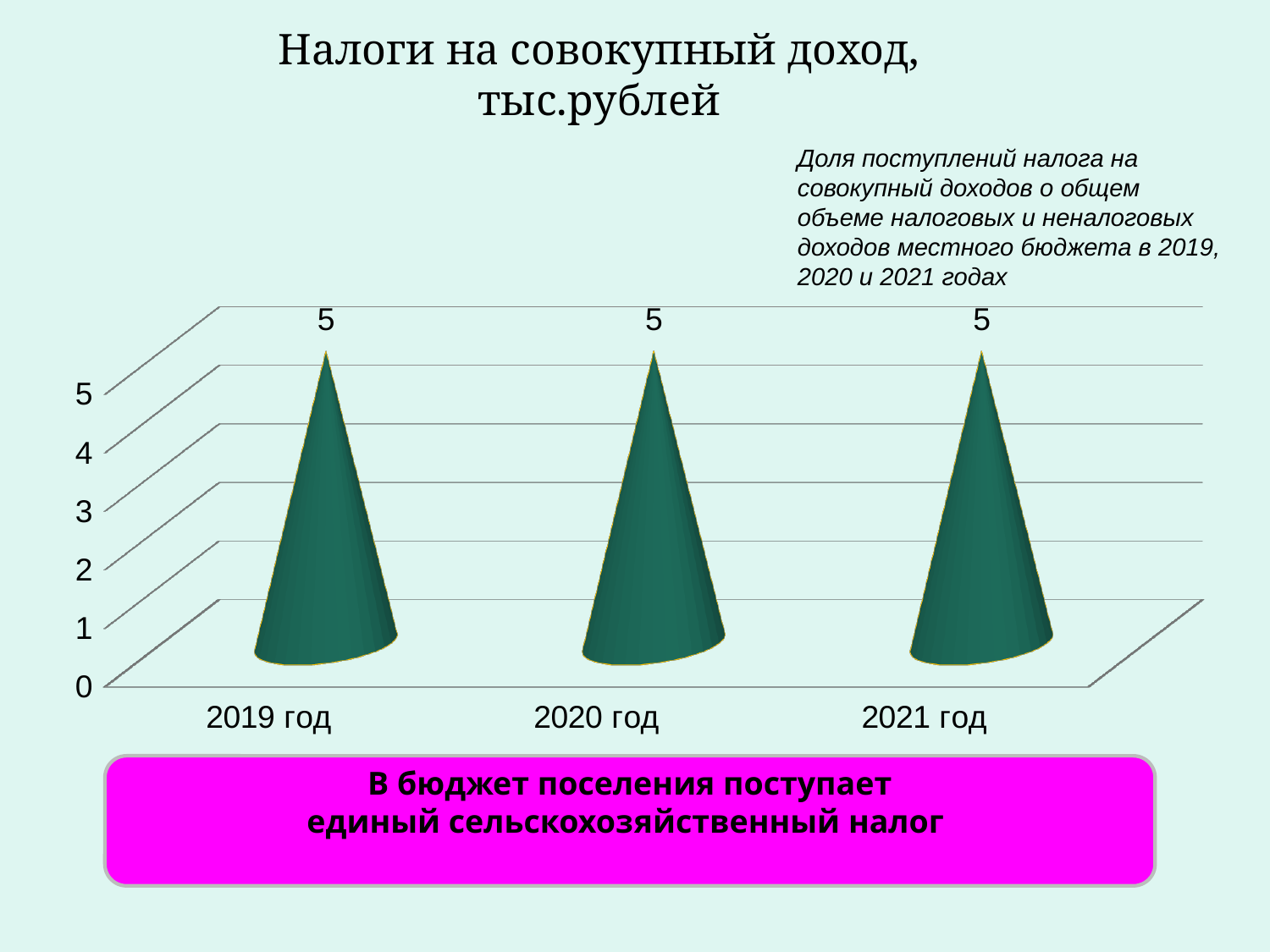
What is the value for 2020 год? 5 What is the highest tick value shown on the vertical axis? 5 What is the value for 2019 год? 5 How many categories are shown on the x axis of the chart? 3 Which is larger, the value for 2019 год or the value for 2020 год? They are equal What kind of chart is shown on the slide? Bar chart What colour are the bars in the chart? Dark green What is the title of the chart? Налоги на совокупный доход, тыс.рублей Do the values rise, fall or stay the same from 2019 год to 2021 год? Stay the same What is the difference between the values for 2021 год and 2019 год? 0 Is the value for 2020 год greater or less than 4? greater What is the value for 2021 год? 5